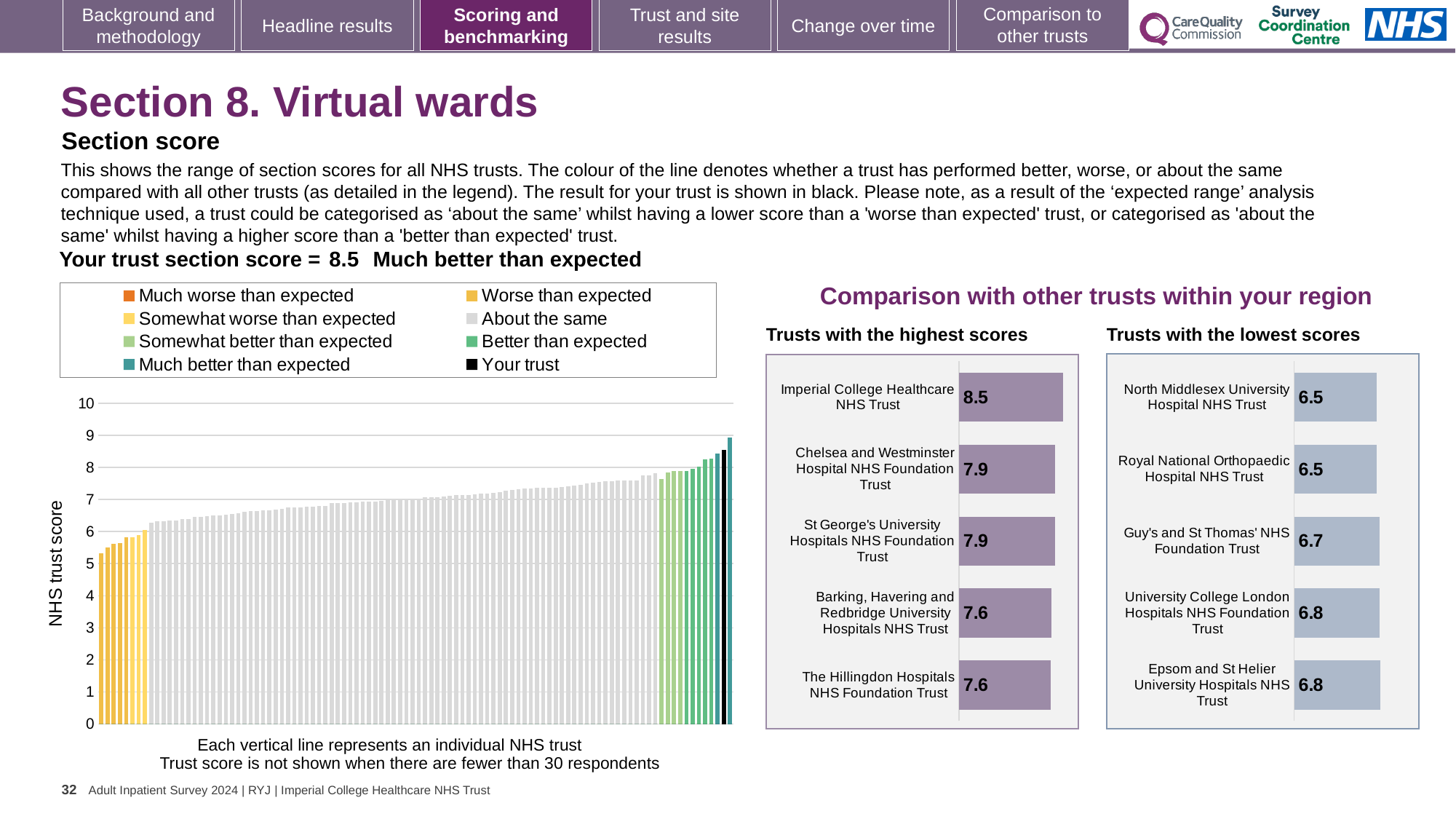
In the 'Trusts with the highest scores' chart, what is the difference between the scores of Imperial College Healthcare NHS Trust and Chelsea and Westminster Hospital NHS Foundation Trust? 0.6 In the 'Trusts with the highest scores' chart, what is the score for The Hillingdon Hospitals NHS Foundation Trust? 7.6 How many entries does the legend of the main NHS trust score chart list? 8 In the 'Trusts with the lowest scores' chart, what is the score for University College London Hospitals NHS Foundation Trust? 6.8 In the 'Trusts with the lowest scores' chart, what is the difference between the scores of Guy's and St Thomas' NHS Foundation Trust and Royal National Orthopaedic Hospital NHS Trust? 0.2 In the 'Trusts with the lowest scores' chart, what is the score for North Middlesex University Hospital NHS Trust? 6.5 In the 'Trusts with the highest scores' chart, which has the larger score: Barking, Havering and Redbridge University Hospitals NHS Trust or St George's University Hospitals NHS Foundation Trust? St George's University Hospitals NHS Foundation Trust In the 'Trusts with the highest scores' chart, what is the score for Imperial College Healthcare NHS Trust? 8.5 In the main NHS trust score chart, is the value of the leftmost bar greater or less than 6? less What type of chart is the main chart showing NHS trust scores? Bar chart In the 'Trusts with the highest scores' chart, which trust has the highest score? Imperial College Healthcare NHS Trust How many trusts are shown in the 'Trusts with the lowest scores' chart? 5